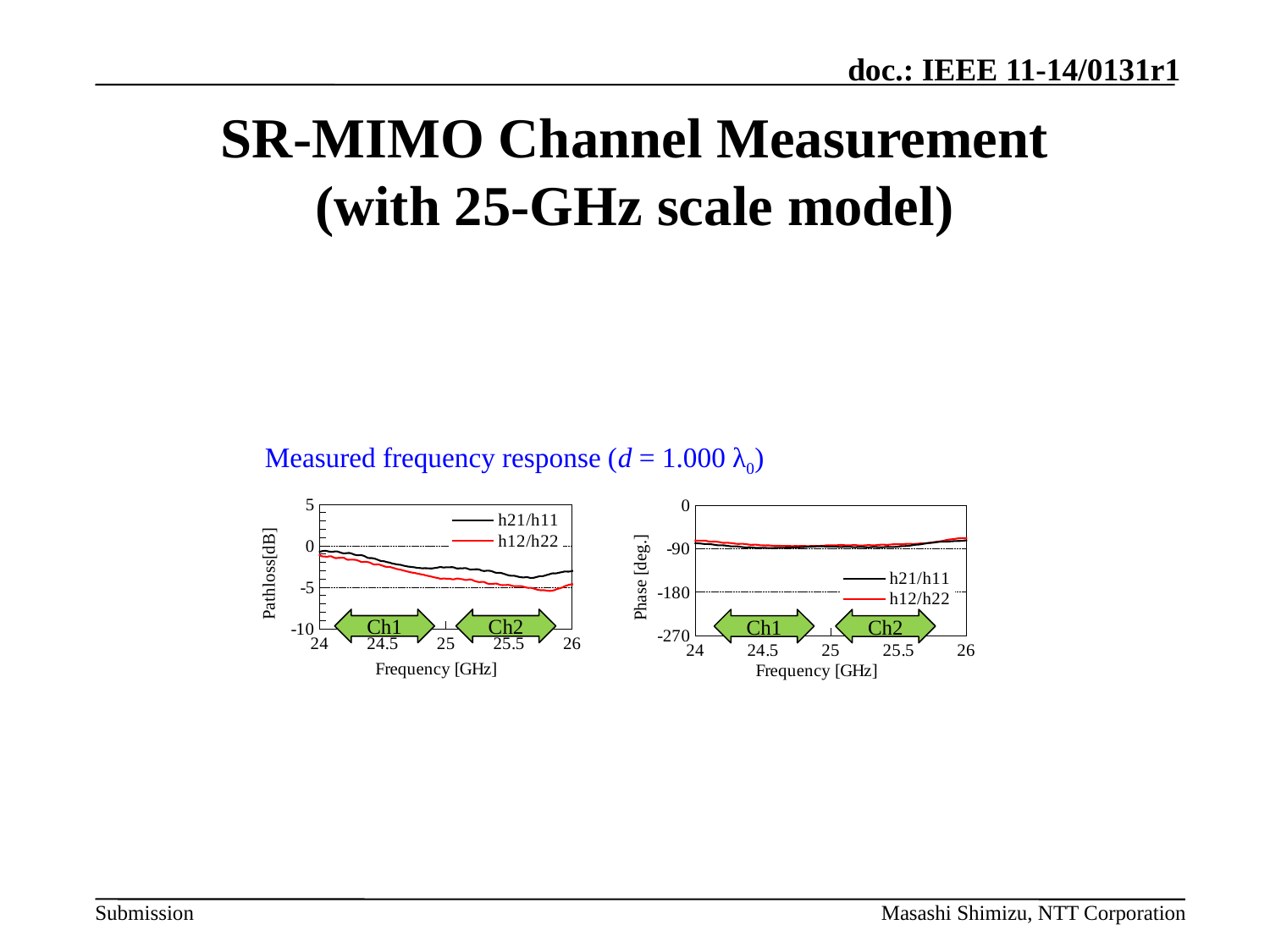
How many series does the legend of the left chart (Pathloss[dB]) list? 2 What kind of chart is the left chart (Pathloss vs Frequency)? line chart In the left chart (Pathloss[dB]), at 25.5 GHz, which series has the higher value, h21/h11 or h12/h22? h21/h11 What are the two series named in the legend of the right chart (Phase [deg.])? h21/h11 and h12/h22 In the right chart (Phase [deg.]), is the h21/h11 value at 26 GHz greater or less than -180? greater In the left chart (Pathloss[dB]), is the h21/h11 value at 24 GHz greater or less than -5? greater In the right chart (Phase [deg.]), is the h12/h22 value at 24 GHz greater or less than -90? greater What is the lowest value shown on the y axis of the right chart (Phase [deg.])? -270 In the left chart (Pathloss[dB]), do the values generally rise or fall as frequency increases from 24 to 26 GHz? fall What is the highest value shown on the y axis of the left chart (Pathloss[dB])? 5 In the left chart (Pathloss[dB]), which colour is the h12/h22 line? red